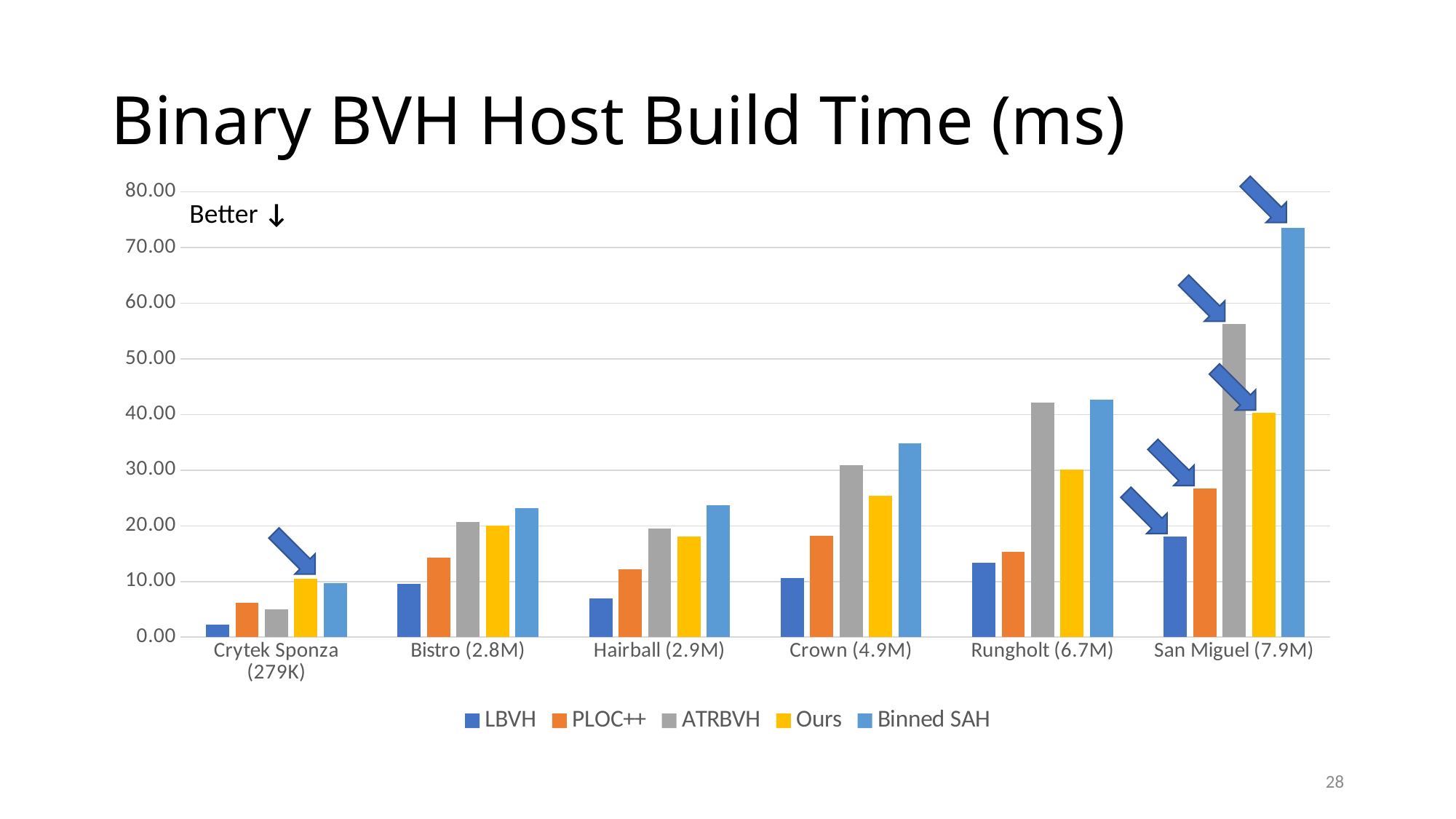
What is the title of the chart? Binary BVH Host Build Time (ms) For which scene is the Binned SAH build time highest? San Miguel (7.9M) Is the ATRBVH value for Rungholt (6.7M) greater or less than 40.00? greater How many scene categories are shown on the x axis? 6 For which scene is the LBVH build time lowest? Crytek Sponza (279K) How many series does the legend list? 5 For Crown (4.9M), which is larger: ATRBVH or Ours? ATRBVH Is the Binned SAH value for San Miguel (7.9M) greater or less than 70.00? greater What kind of chart is shown on the slide? Bar chart For San Miguel (7.9M), which is larger: Binned SAH or ATRBVH? Binned SAH Is the LBVH value for Hairball (2.9M) greater or less than 10.00? less Does the Binned SAH build time generally rise or fall from Crytek Sponza to San Miguel? Rise